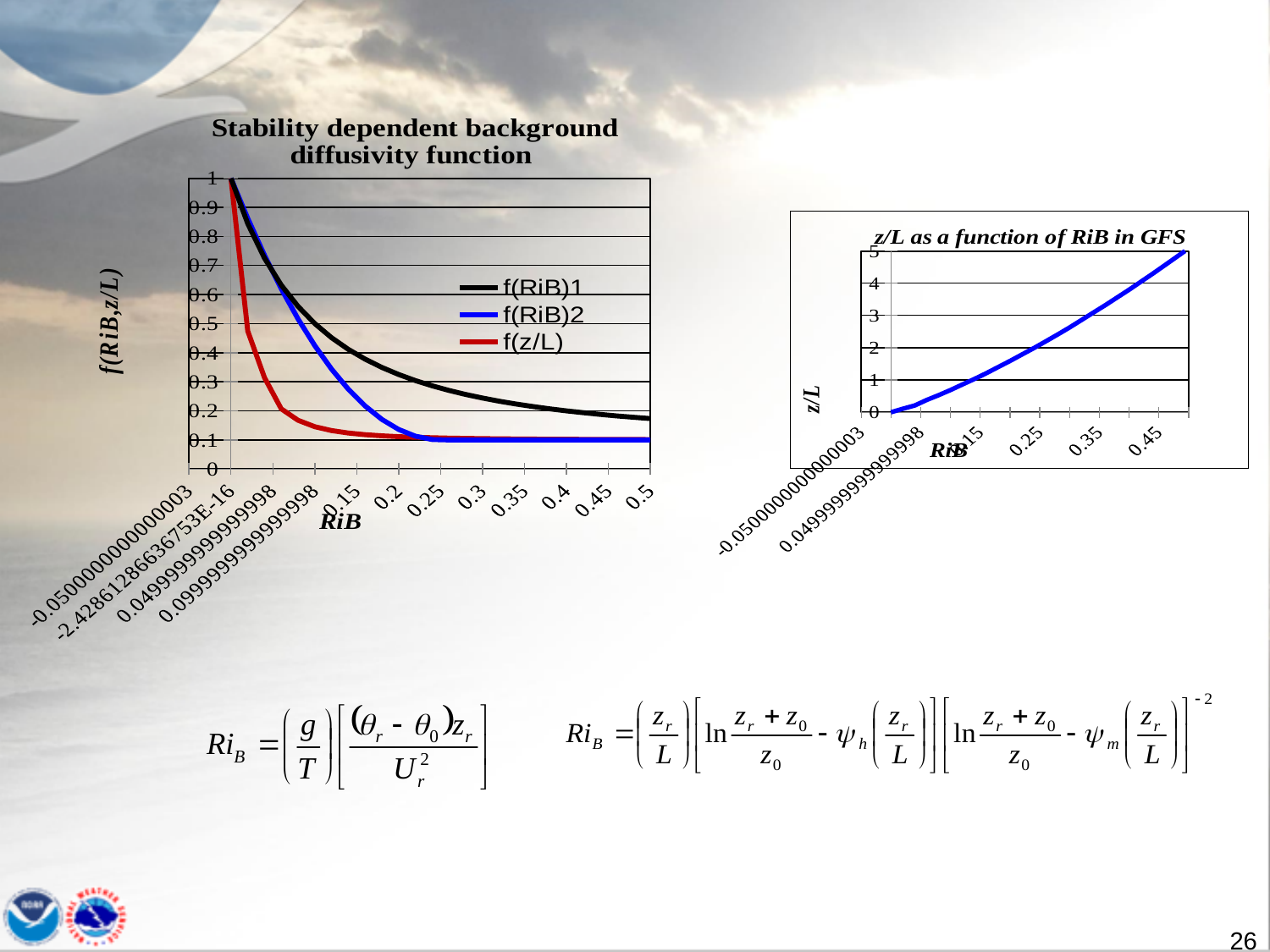
How many series does the legend of the 'Stability dependent background diffusivity function' chart list? 3 What is the title of the chart on the right of the slide? z/L as a function of RiB in GFS In the 'Stability dependent background diffusivity function' chart, is the value of f(RiB)1 at RiB = 0.5 greater or less than 0.1? greater What kind of chart is the 'z/L as a function of RiB in GFS' chart? line chart In the 'Stability dependent background diffusivity function' chart, which series is drawn in red? f(z/L) In the 'Stability dependent background diffusivity function' chart, do the values of f(RiB)1 rise or fall as RiB increases? fall In the 'Stability dependent background diffusivity function' chart, which series has the highest value at RiB = 0.5? f(RiB)1 In the 'Stability dependent background diffusivity function' chart, is the value of f(RiB)1 at RiB = 0.2 greater or less than 0.2? greater In the 'Stability dependent background diffusivity function' chart, at RiB = 0.2, which is larger: f(RiB)1 or f(z/L)? f(RiB)1 In the 'z/L as a function of RiB in GFS' chart, do the values rise or fall as RiB increases? rise In the 'z/L as a function of RiB in GFS' chart, is the value of z/L at RiB = 0.45 greater or less than 4? greater What kind of chart is the 'Stability dependent background diffusivity function' chart? line chart